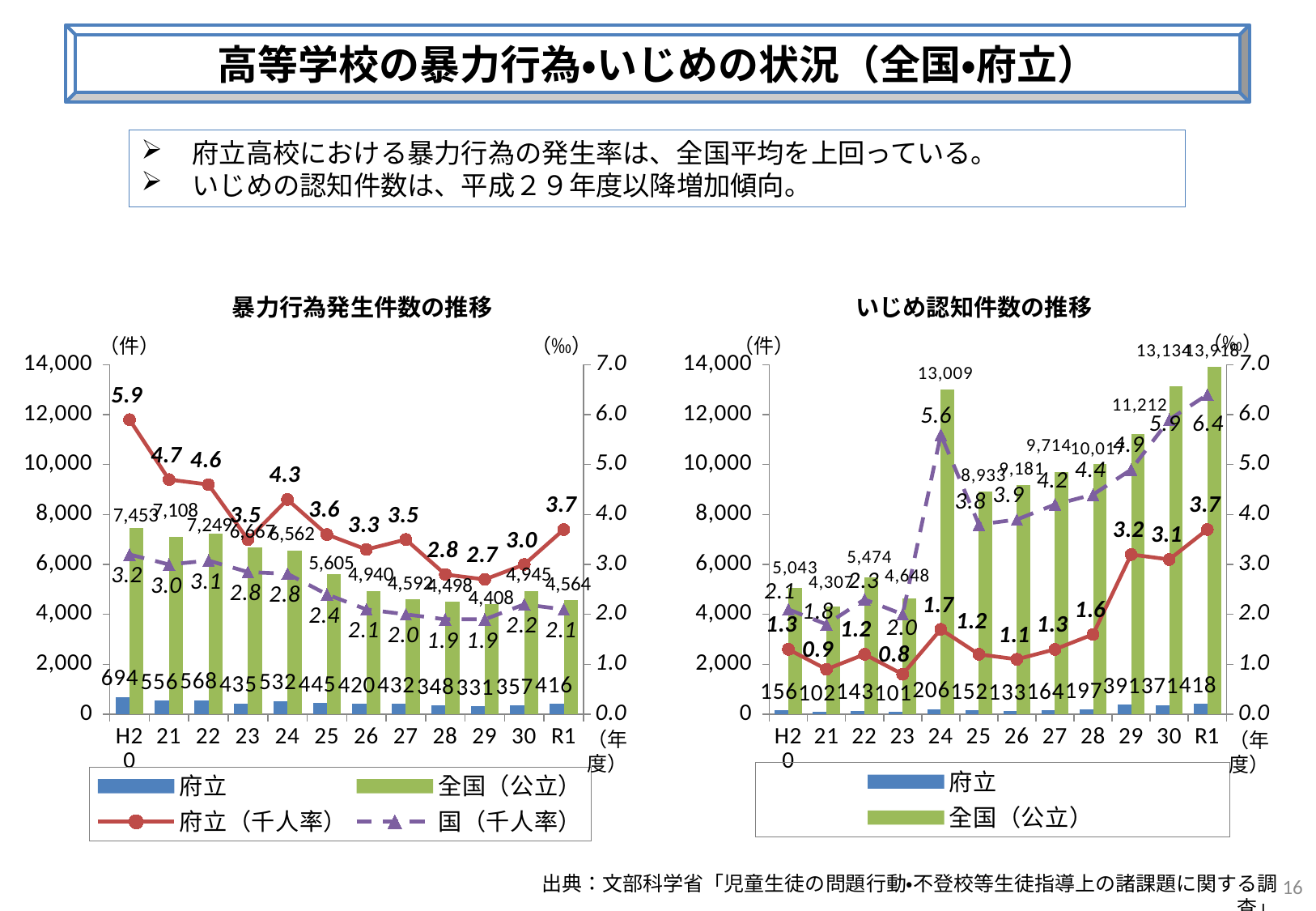
In the 暴力行為発生件数の推移 chart, what is the 全国（公立） value for 25? 5,605 How many series does the legend of the 暴力行為発生件数の推移 chart list? 4 In the 暴力行為発生件数の推移 chart, what is the difference between the 全国（公立） values for H20 and R1? 2,889 In the 暴力行為発生件数の推移 chart, in which year is the 府立（千人率） line highest? H20 In the 暴力行為発生件数の推移 chart, what is the 府立 value for H20? 694 In the いじめ認知件数の推移 chart, which is larger, the 府立 value for 29 or for 30? 29 In the 暴力行為発生件数の推移 chart, does the 府立（千人率） line generally rise or fall from H20 to 29? fall In the いじめ認知件数の推移 chart, what is the 全国（公立） value for 24? 13,009 How many years are shown on the x axis of the 暴力行為発生件数の推移 chart? 12 In the いじめ認知件数の推移 chart, in which year is the 府立 bar highest? R1 What kind of chart is the いじめ認知件数の推移 chart? Combined bar and line chart In the 暴力行為発生件数の推移 chart, in which year is the 府立 bar lowest? 29